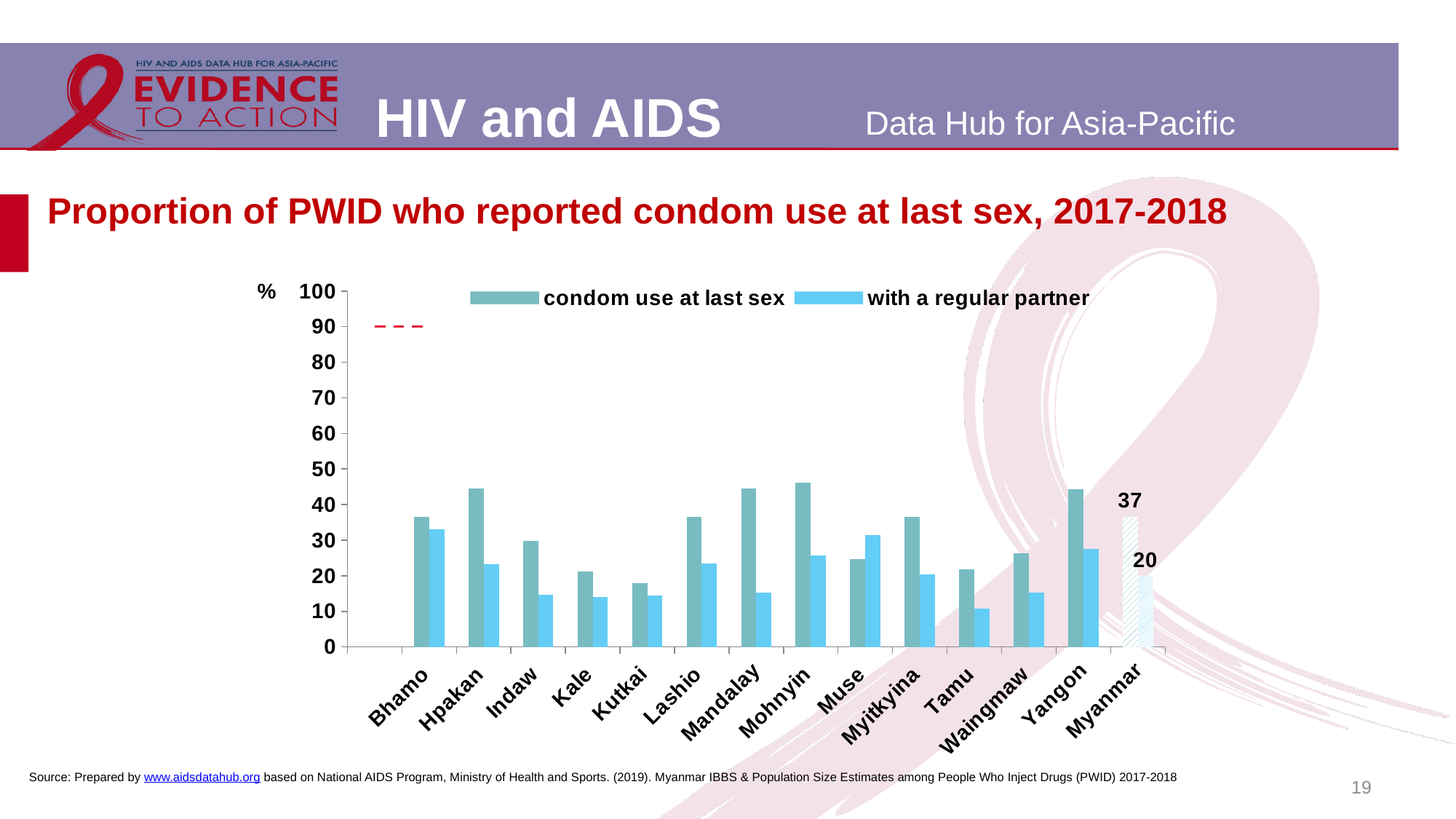
Is the 'with a regular partner' value for Indaw greater or less than 20? less For Hpakan, which series has the larger value: 'condom use at last sex' or 'with a regular partner'? condom use at last sex Which location has the lowest value in the 'with a regular partner' series? Tamu What is the difference between the Myanmar values for 'condom use at last sex' and 'with a regular partner'? 17 What is the value for Myanmar in the 'condom use at last sex' series? 37 How many series does the chart legend list? 2 How many locations are shown on the x axis of the chart? 14 Which location has the lowest value in the 'condom use at last sex' series? Kutkai Is the 'condom use at last sex' value for Mohnyin greater or less than 50? less What kind of chart is shown on the slide? bar chart Is the 'condom use at last sex' value for Bhamo greater or less than 30? greater What is the value for Myanmar in the 'with a regular partner' series? 20